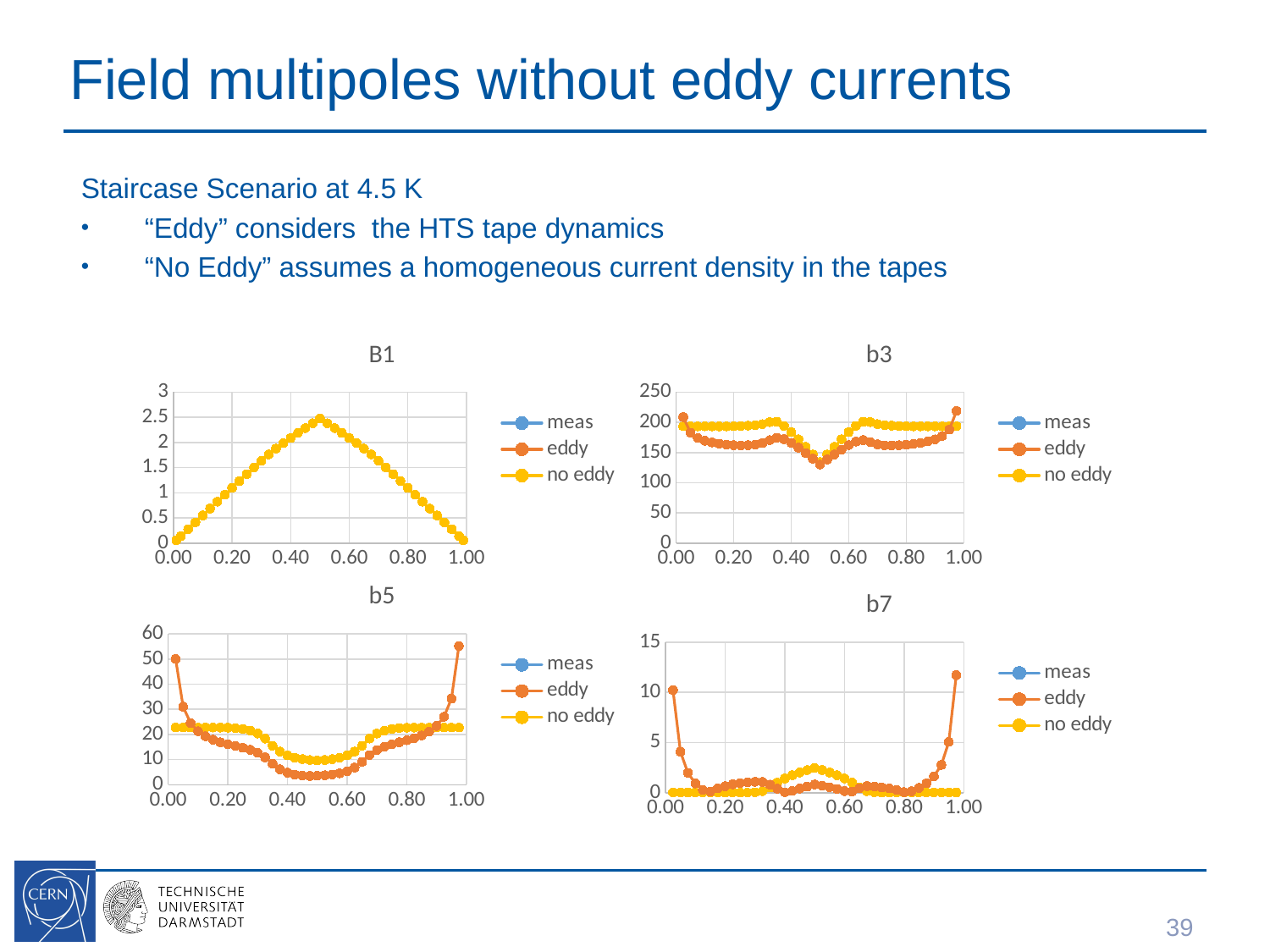
How many charts are shown on the slide? 4 In the b7 chart, is the no eddy value at x = 0.50 greater or less than 5? less In the B1 chart, do the values rise or fall along the x axis from 0.00 to 0.50? rise In the b7 chart, is the eddy value at x = 1.00 greater or less than 10? greater What kind of chart is the b3 chart? line chart In the b5 chart, at x = 0.50, which series has the larger value, eddy or no eddy? no eddy In the b5 chart, what are the three legend entries? meas, eddy, no eddy In the B1 chart, is the value at x = 0.50 greater or less than 2? greater In the B1 chart, how many series does the legend list? 3